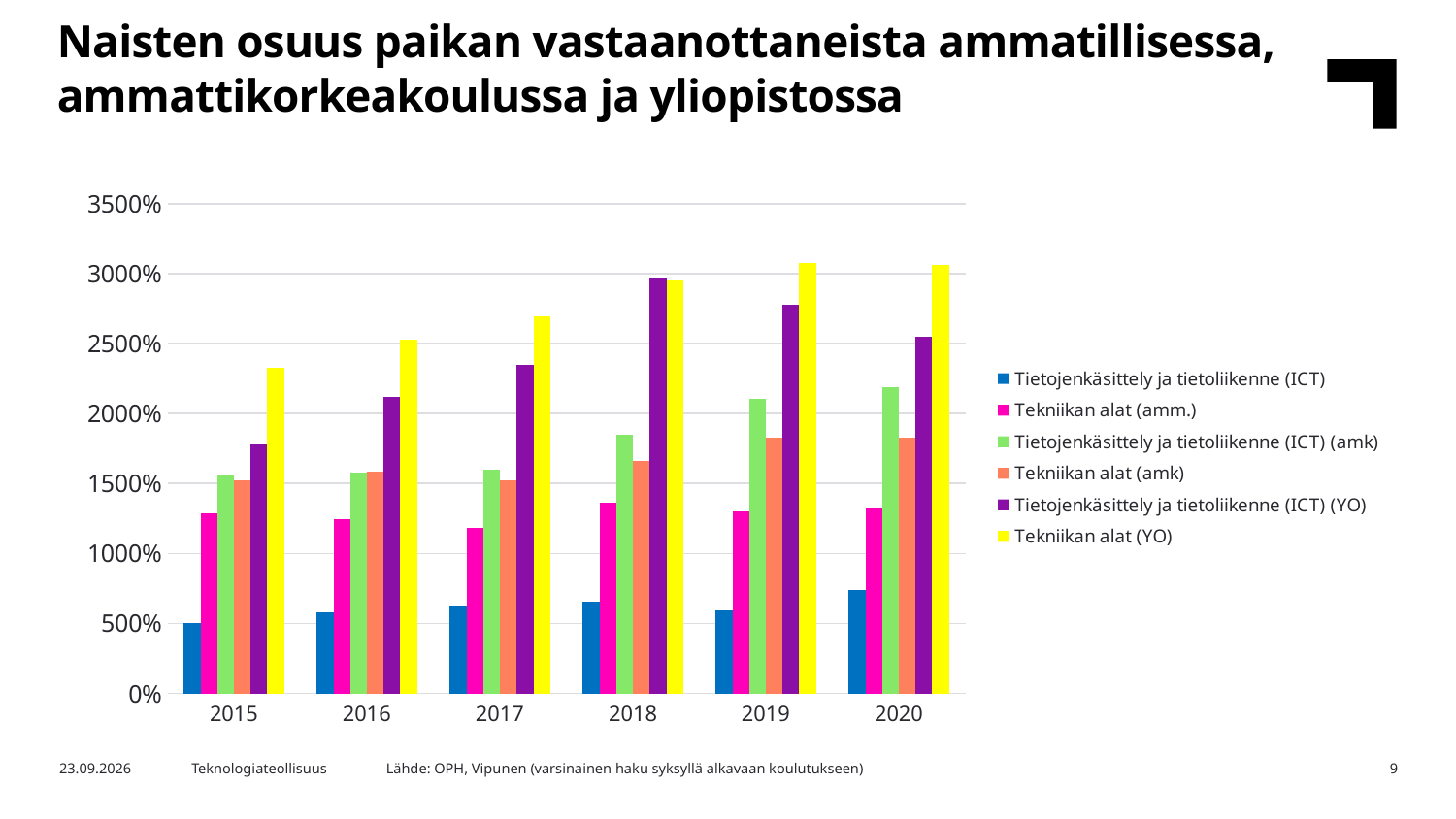
Which series has the lowest bar in every year shown? Tietojenkäsittely ja tietoliikenne (ICT) Is the value for Tekniikan alat (YO) in 2019 greater or less than 3000%? greater Is the value for Tietojenkäsittely ja tietoliikenne (ICT) in 2020 greater or less than 1000%? less How many series does the chart legend list? 6 Is the value for Tekniikan alat (YO) in 2015 greater or less than 2500%? less Do the values for Tekniikan alat (YO) rise or fall from 2015 to 2019? rise Which year has the lowest bar for Tietojenkäsittely ja tietoliikenne (ICT)? 2015 What kind of chart is shown on the slide? Bar chart What colour are the bars for Tekniikan alat (YO) in the chart? Yellow How many years are shown on the x axis of the chart? 6 In 2015, which is larger: Tietojenkäsittely ja tietoliikenne (ICT) (amk) or Tekniikan alat (amm.)? Tietojenkäsittely ja tietoliikenne (ICT) (amk)